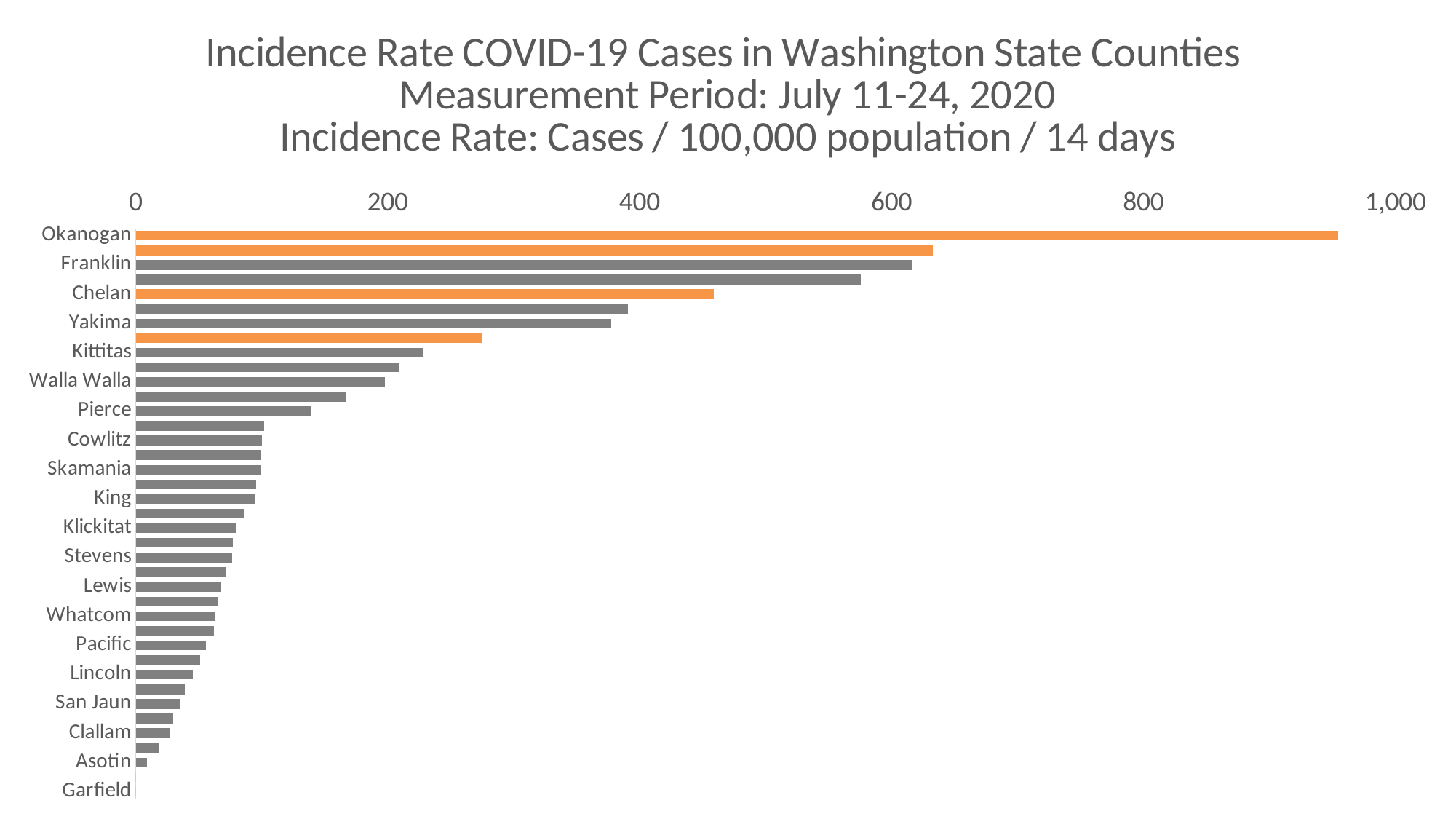
What kind of chart is shown on the slide? bar chart Which county has the lowest incidence rate? Garfield Is the value for Yakima greater or less than 400? less Which has a higher incidence rate, Chelan or Yakima? Chelan Is the value for Pierce greater or less than 200? less Which has a higher incidence rate, Okanogan or Franklin? Okanogan Which county has the highest incidence rate? Okanogan Is the value for Franklin greater or less than 400? greater Do the bar values rise or fall going from the top of the chart to the bottom? fall What colour is the bar for Okanogan? orange